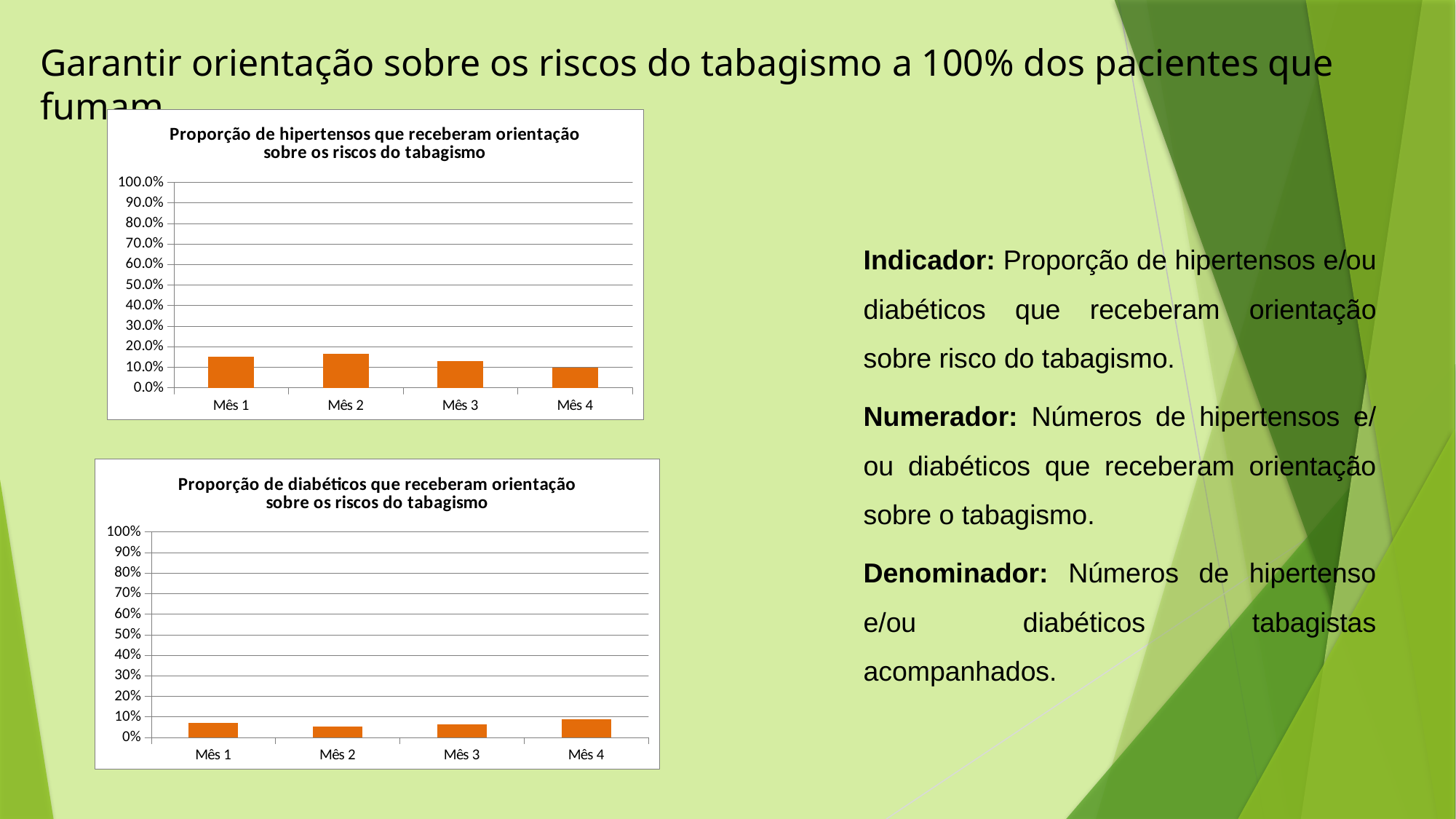
In the top chart about hipertensos, which month has the lowest proportion? Mês 4 In the top chart about hipertensos, which is larger, the value for Mês 1 or the value for Mês 4? Mês 1 In the bottom chart about diabéticos, which month has the highest proportion? Mês 4 In the bottom chart about diabéticos, is the value for Mês 4 greater or less than 10%? less In the top chart about hipertensos, do the values rise or fall from Mês 2 to Mês 4? fall In the top chart about hipertensos, is the value for Mês 2 greater or less than 20.0%? less What is the title of the bottom chart? Proporção de diabéticos que receberam orientação sobre os riscos do tabagismo In the top chart about hipertensos, which month has the highest proportion? Mês 2 In the top chart about hipertensos, is the value for Mês 1 greater or less than 10.0%? greater How many categories (months) are shown on the x axis of the top chart about hipertensos? 4 What kind of chart is the top chart, 'Proporção de hipertensos que receberam orientação sobre os riscos do tabagismo'? bar chart In the bottom chart about diabéticos, which is larger, the value for Mês 2 or the value for Mês 4? Mês 4